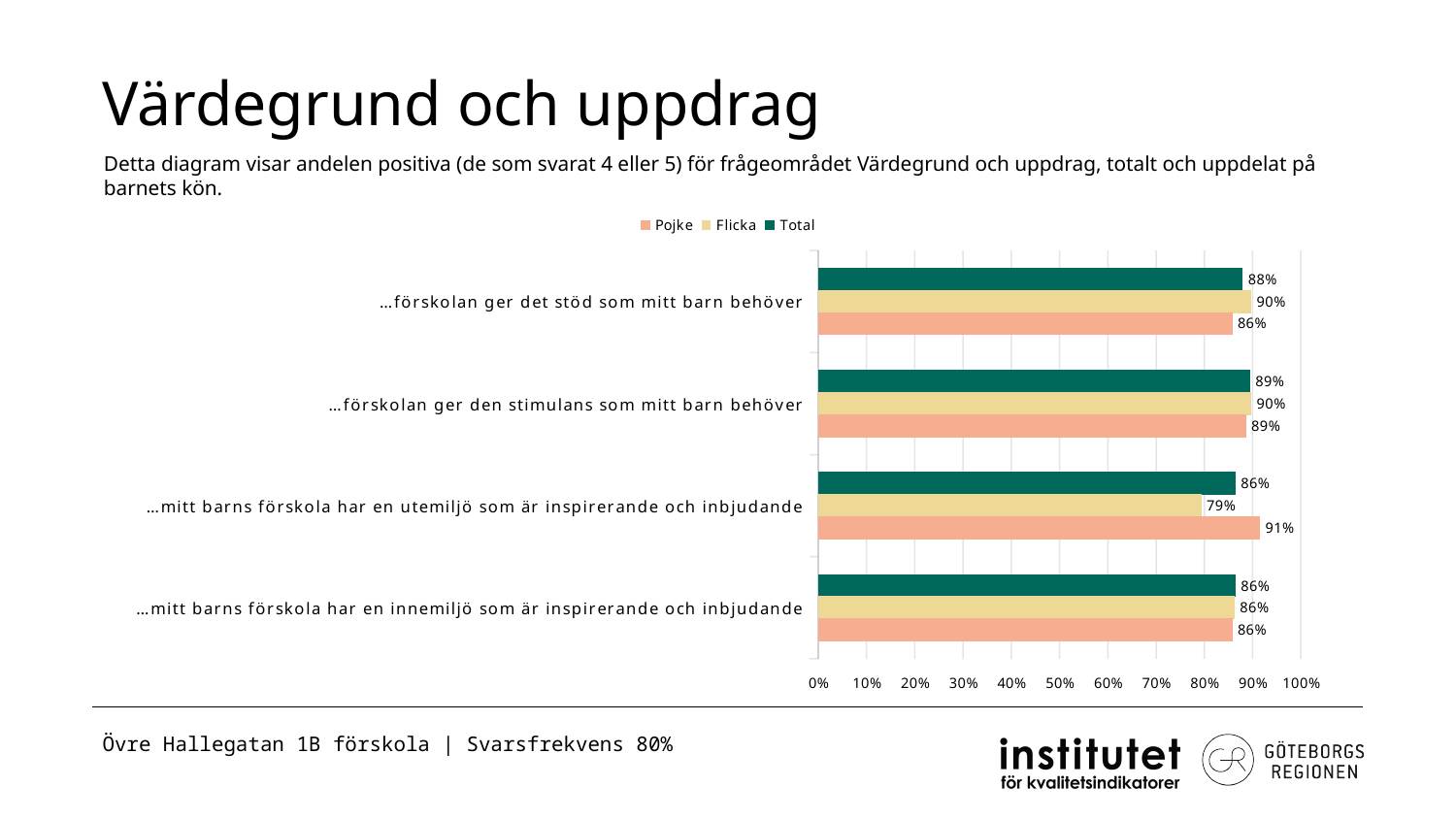
How many series does the legend list? 3 Which statement has the lowest Flicka value? …mitt barns förskola har en utemiljö som är inspirerande och inbjudande What is the Total value for "…förskolan ger det stöd som mitt barn behöver"? 88% What type of chart is shown on the slide? bar chart What is the difference between the Pojke and Flicka values for "…mitt barns förskola har en utemiljö som är inspirerande och inbjudande"? 12% Which series is shown in green in the legend? Total Which statement has the highest Pojke value? …mitt barns förskola har en utemiljö som är inspirerande och inbjudande How many categories (statements) are shown on the chart? 4 What is the Pojke value for "…mitt barns förskola har en utemiljö som är inspirerande och inbjudande"? 91% What is the Flicka value for "…mitt barns förskola har en utemiljö som är inspirerande och inbjudande"? 79% For "…förskolan ger det stöd som mitt barn behöver", which is larger, the Flicka value or the Pojke value? Flicka What is the Pojke value for "…förskolan ger den stimulans som mitt barn behöver"? 89%